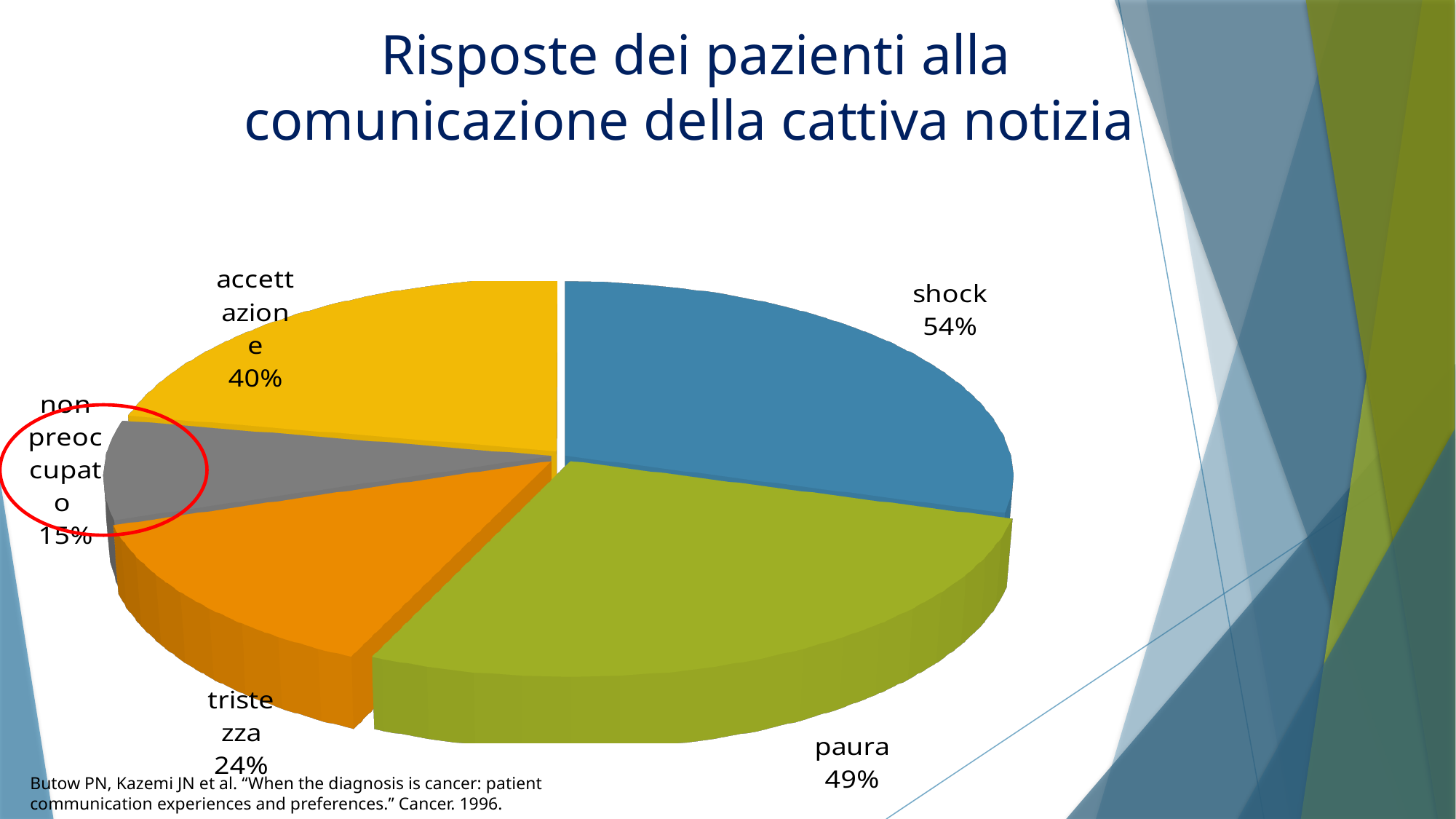
How many categories are shown in the pie chart? 5 Which is larger, the value for "accettazione" or the value for "tristezza"? accettazione What is the value shown for "paura"? 49% What is the value shown for "shock"? 54% What type of chart is shown on the slide? pie chart Which category is circled in red on the chart? non preoccupato What is the value shown for "non preoccupato"? 15% What is the value shown for "accettazione"? 40% Which category has the highest value? shock What is the difference between the values for "shock" and "paura"? 5% Which category has the lowest value? non preoccupato What is the value shown for "tristezza"? 24%